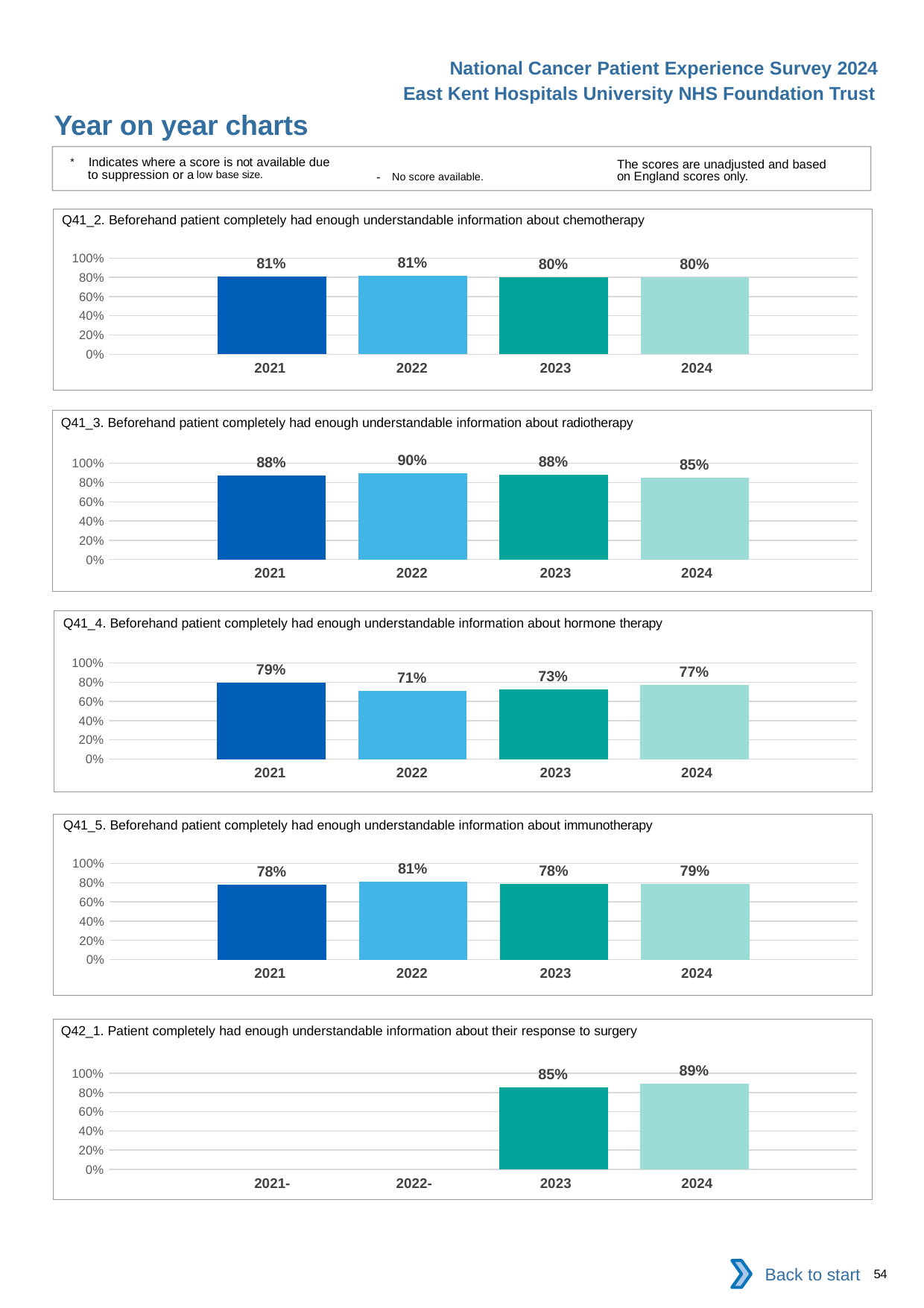
In the Q41_3 chart about radiotherapy, which year has the highest value? 2022 In the Q41_3 chart about radiotherapy, do the values rise or fall from 2022 to 2024? Fall In the Q42_1 chart about response to surgery, what is the difference between the 2024 and 2023 values? 4% In the Q42_1 chart about response to surgery, what is the value for 2024? 89% In the Q42_1 chart about response to surgery, how many years have a bar plotted? 2 In the Q41_2 chart about chemotherapy, what is the value for 2021? 81% What type of chart is the Q41_2 chart about chemotherapy? Bar chart In the Q41_5 chart about immunotherapy, is the value for 2024 larger than the value for 2023? Yes In the Q41_4 chart about hormone therapy, which year has the lowest value? 2022 In the Q41_3 chart about radiotherapy, which year has the lowest value? 2024 In the Q41_5 chart about immunotherapy, what is the value for 2022? 81% In the Q41_4 chart about hormone therapy, what is the difference between the 2021 and 2022 values? 8%